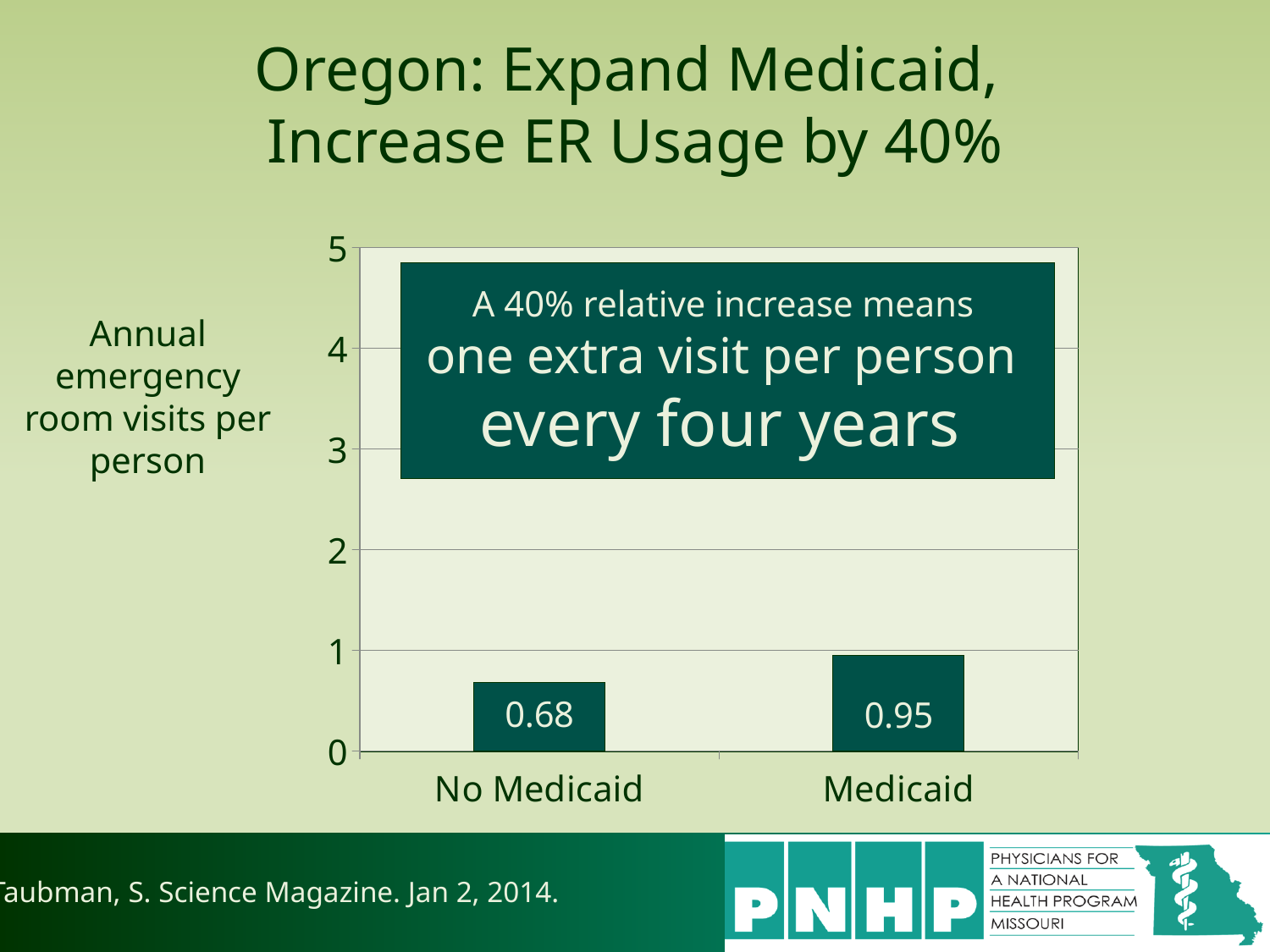
What does the y axis of the chart measure, according to the label to its left? Annual emergency room visits per person What is the annual emergency room visits per person for the No Medicaid group? 0.68 What kind of chart is shown on the slide? bar chart Which category has the lower annual emergency room visits per person? No Medicaid What is the difference in annual emergency room visits per person between the Medicaid and No Medicaid groups? 0.27 How many categories are shown on the x axis of the chart? 2 What is the annual emergency room visits per person for the Medicaid group? 0.95 Which category has the higher annual emergency room visits per person? Medicaid What is the maximum value shown on the y axis of the chart? 5 Is the value for Medicaid greater or less than 1? less Is the value for Medicaid larger or smaller than the value for No Medicaid? larger